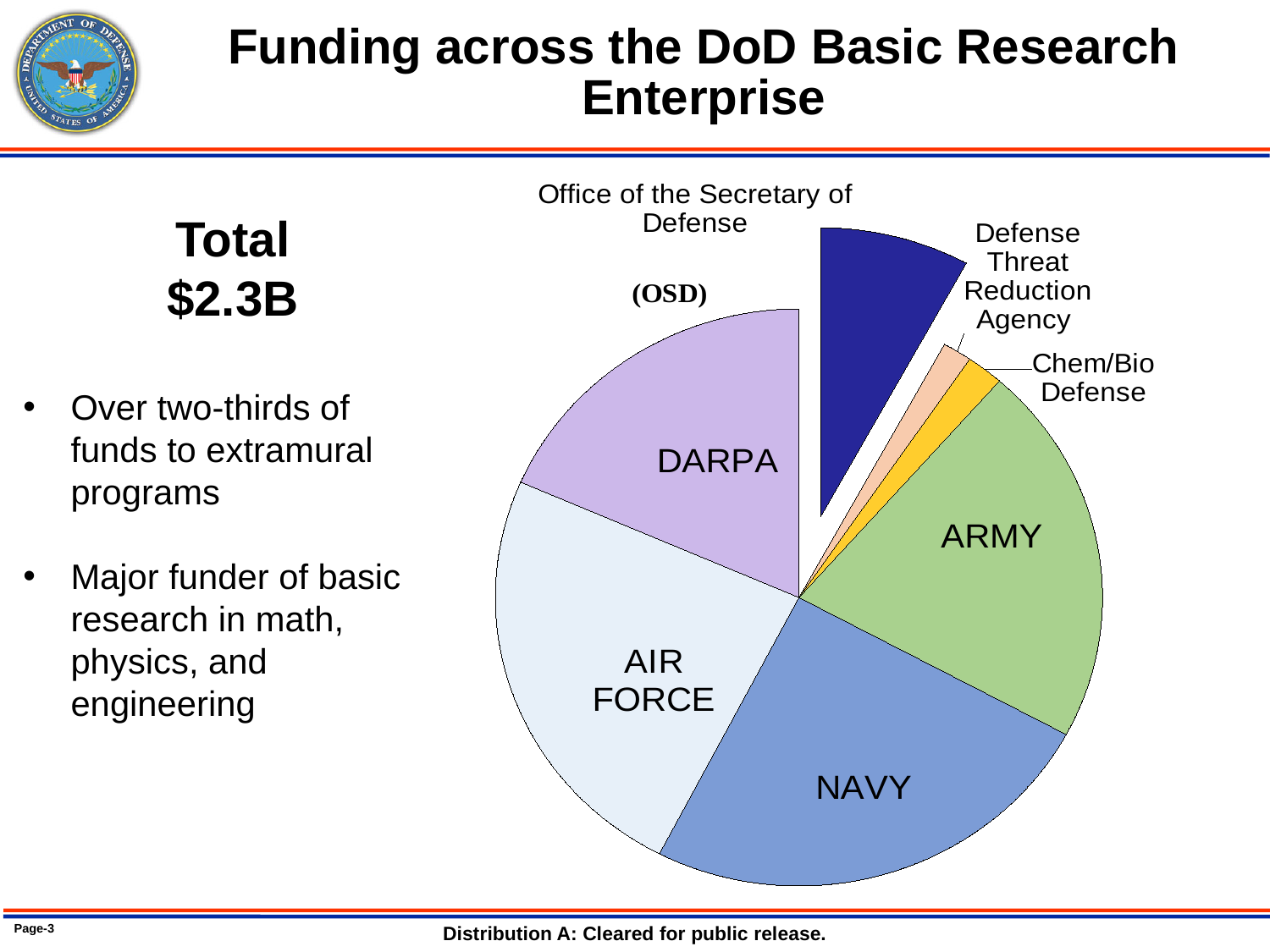
Which slice is larger, DARPA or Defense Threat Reduction Agency? DARPA Which slice is larger, AIR FORCE or Chem/Bio Defense? AIR FORCE Which slice is larger, Office of the Secretary of Defense (OSD) or Chem/Bio Defense? Office of the Secretary of Defense (OSD) Which slice of the pie chart is pulled out (exploded) from the rest of the pie? Office of the Secretary of Defense (OSD) What kind of chart is shown on the slide? pie chart How many slices does the pie chart have? 7 What total funding amount is stated next to the pie chart? $2.3B